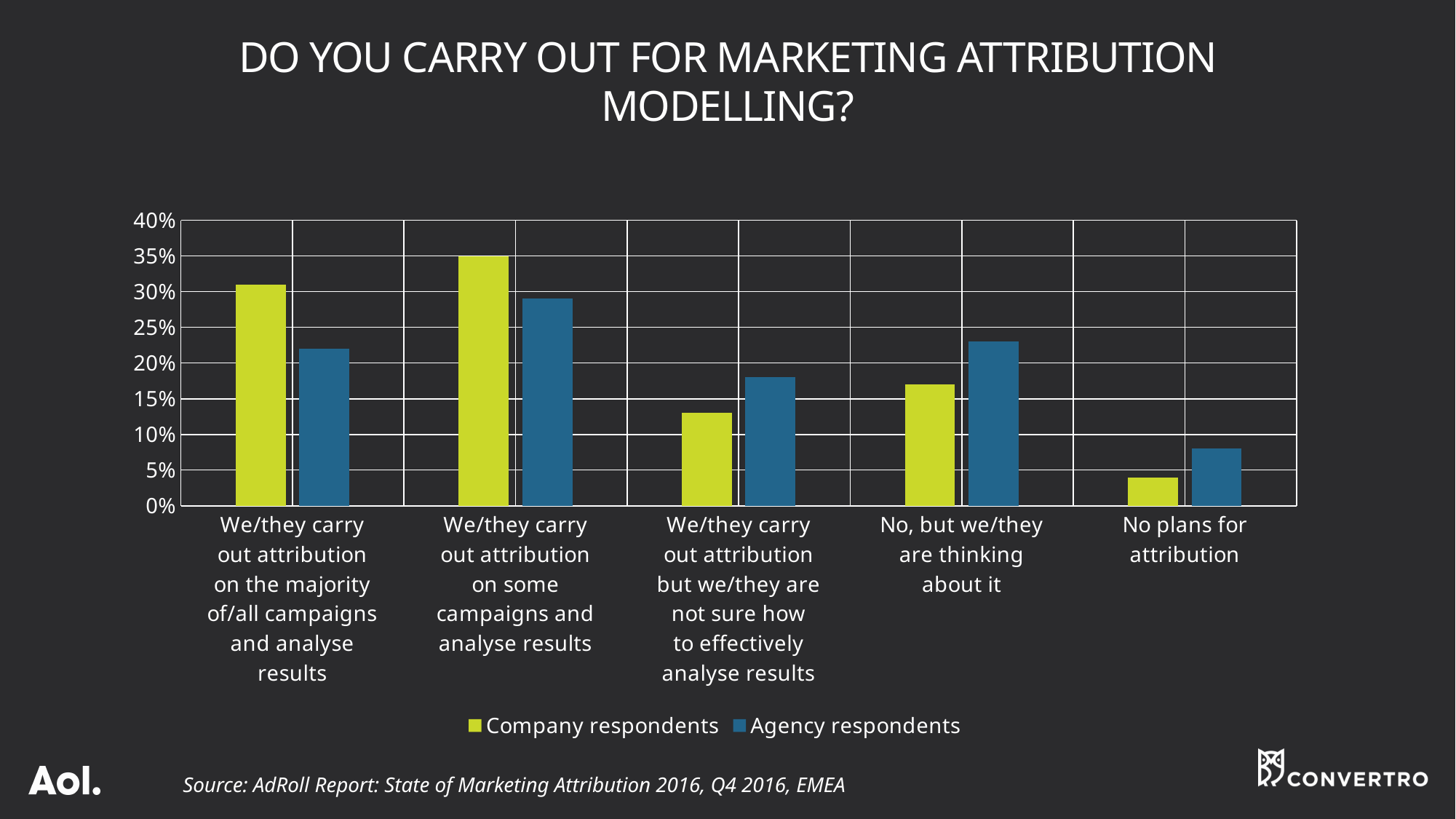
How many series does the legend list? 2 Is the Agency respondents value for 'No, but we/they are thinking about it' greater or less than 20%? greater Is the Agency respondents value for 'No plans for attribution' greater or less than 10%? less For 'We/they carry out attribution on some campaigns and analyse results', which series has the larger value, Company respondents or Agency respondents? Company respondents Which colour represents Agency respondents in the chart? blue Which category has the lowest value for Agency respondents? No plans for attribution What kind of chart is shown on the slide? bar chart For 'We/they carry out attribution but we/they are not sure how to effectively analyse results', which series has the larger value, Company respondents or Agency respondents? Agency respondents Which category has the lowest value for Company respondents? No plans for attribution How many response categories are shown on the x axis? 5 Which category has the highest value for Company respondents? We/they carry out attribution on some campaigns and analyse results